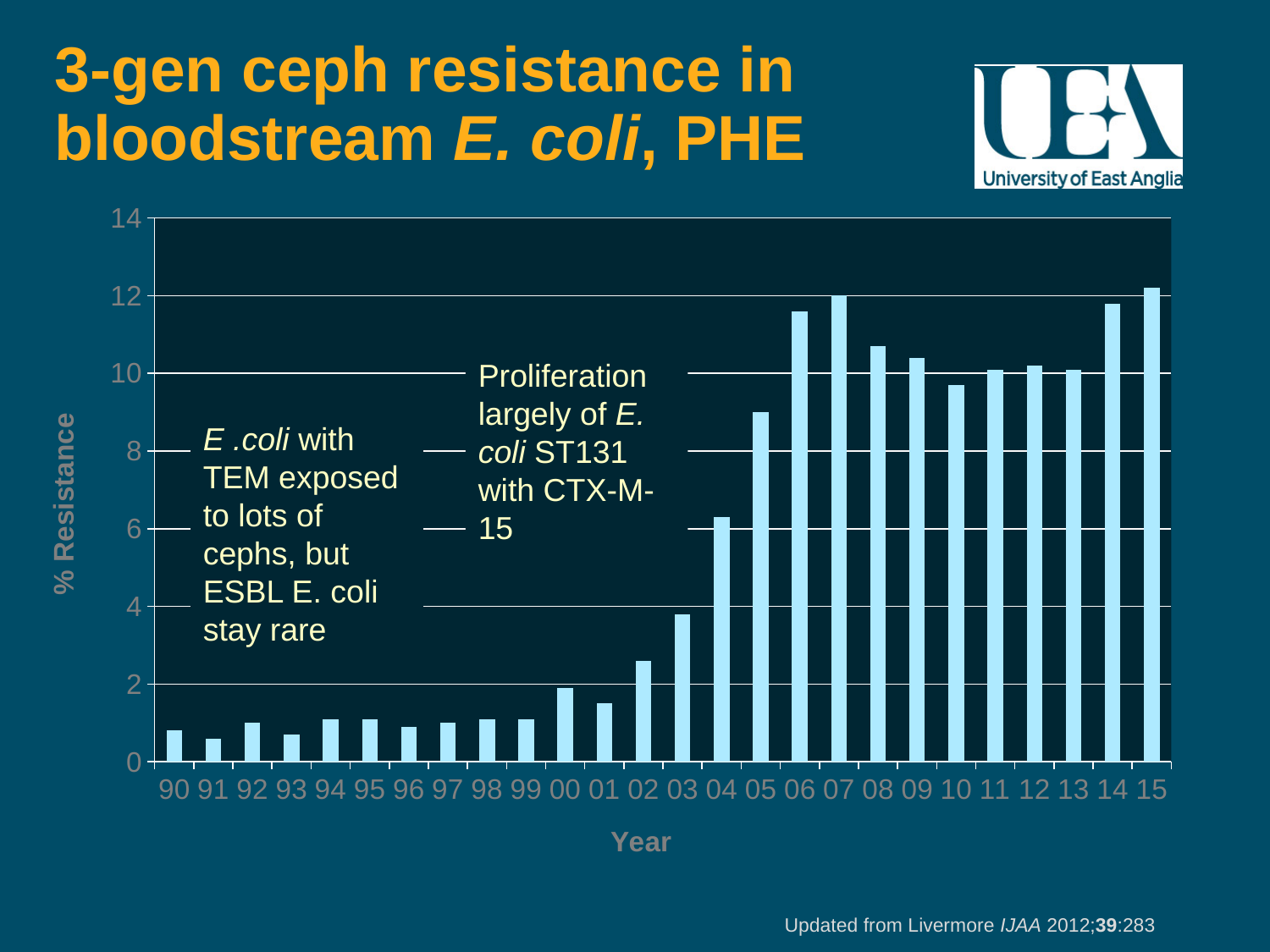
What is the label on the horizontal axis of the chart? Year Overall, do the values rise or fall from 90 to 15 along the x axis? rise Which year has the larger value, 04 or 05? 05 What kind of chart is shown on the slide? bar chart Is the value for 06 greater or less than 10? greater Is the value for 90 greater or less than 2? less Is the value for 05 greater or less than 10? less How many years (bars) are plotted on the chart? 26 What is the label on the vertical axis of the chart? % Resistance Which year has the larger value, 06 or 10? 06